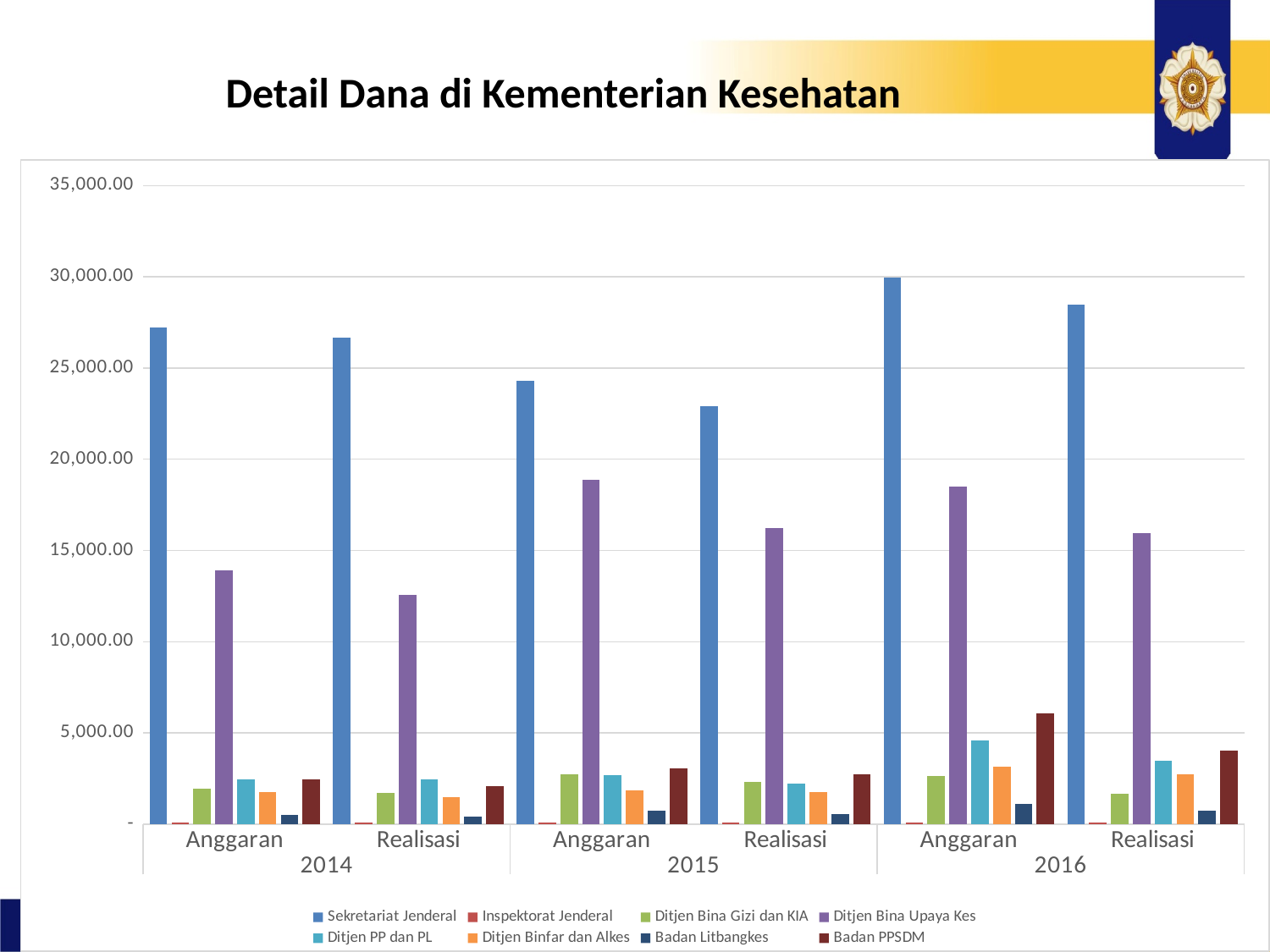
Which series has the highest value in the 2014 Anggaran group? Sekretariat Jenderal What kind of chart is shown on the slide? Bar chart Is the value for Sekretariat Jenderal in the 2016 Anggaran group greater or less than 25,000.00? greater Is the value for Sekretariat Jenderal in the 2015 Realisasi group greater or less than 20,000.00? greater Which is larger for Ditjen Bina Upaya Kes: the 2014 Anggaran value or the 2015 Anggaran value? 2015 Anggaran Which series has the lowest value in the 2016 Realisasi group? Inspektorat Jenderal How many category groups (Anggaran/Realisasi) are shown along the x axis? 6 Which is larger for Sekretariat Jenderal: the 2014 Anggaran value or the 2016 Anggaran value? 2016 Anggaran Is the value for Ditjen Bina Upaya Kes in the 2014 Realisasi group greater or less than 15,000.00? less For Badan PPSDM in 2016, which is larger: Anggaran or Realisasi? Anggaran What is the title of the slide? Detail Dana di Kementerian Kesehatan How many series does the legend list? 8